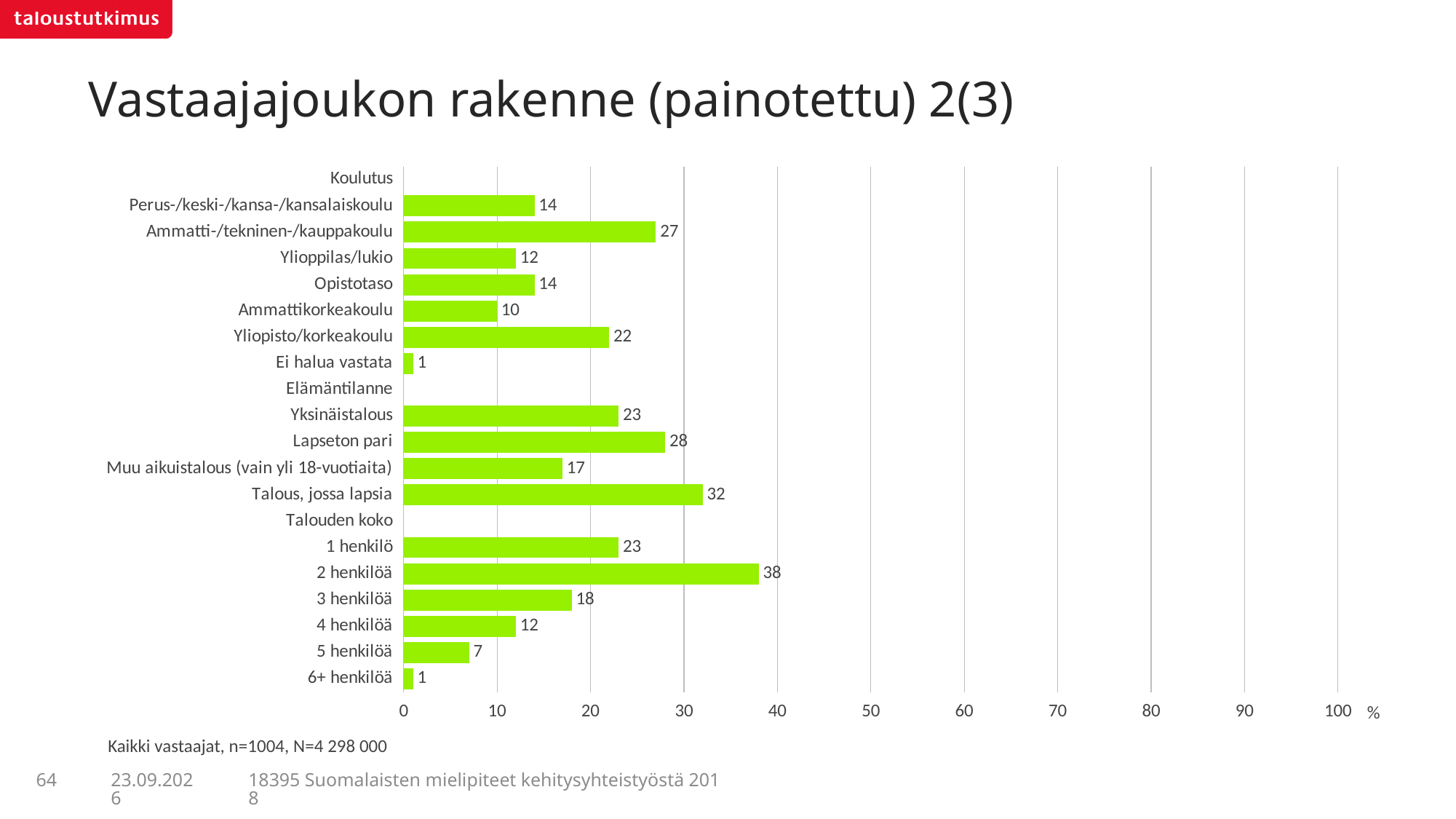
Which category under Elämäntilanne has the lowest value? Muu aikuistalous (vain yli 18-vuotiaita) How many categories under Talouden koko have bars? 6 What is the value for Ammattikorkeakoulu? 10 What is the title of the slide? Vastaajajoukon rakenne (painotettu) 2(3) Which category has the highest value in the chart? 2 henkilöä Which is larger, the value for Yliopisto/korkeakoulu or the value for Ylioppilas/lukio? Yliopisto/korkeakoulu What is the value for 2 henkilöä? 38 What is the difference between the values for Lapseton pari and Yksinäistalous? 5 What is the value for Ammatti-/tekninen-/kauppakoulu? 27 Is the value for 3 henkilöä greater or less than 20? less What is the value for Talous, jossa lapsia? 32 What kind of chart is shown on the slide? bar chart